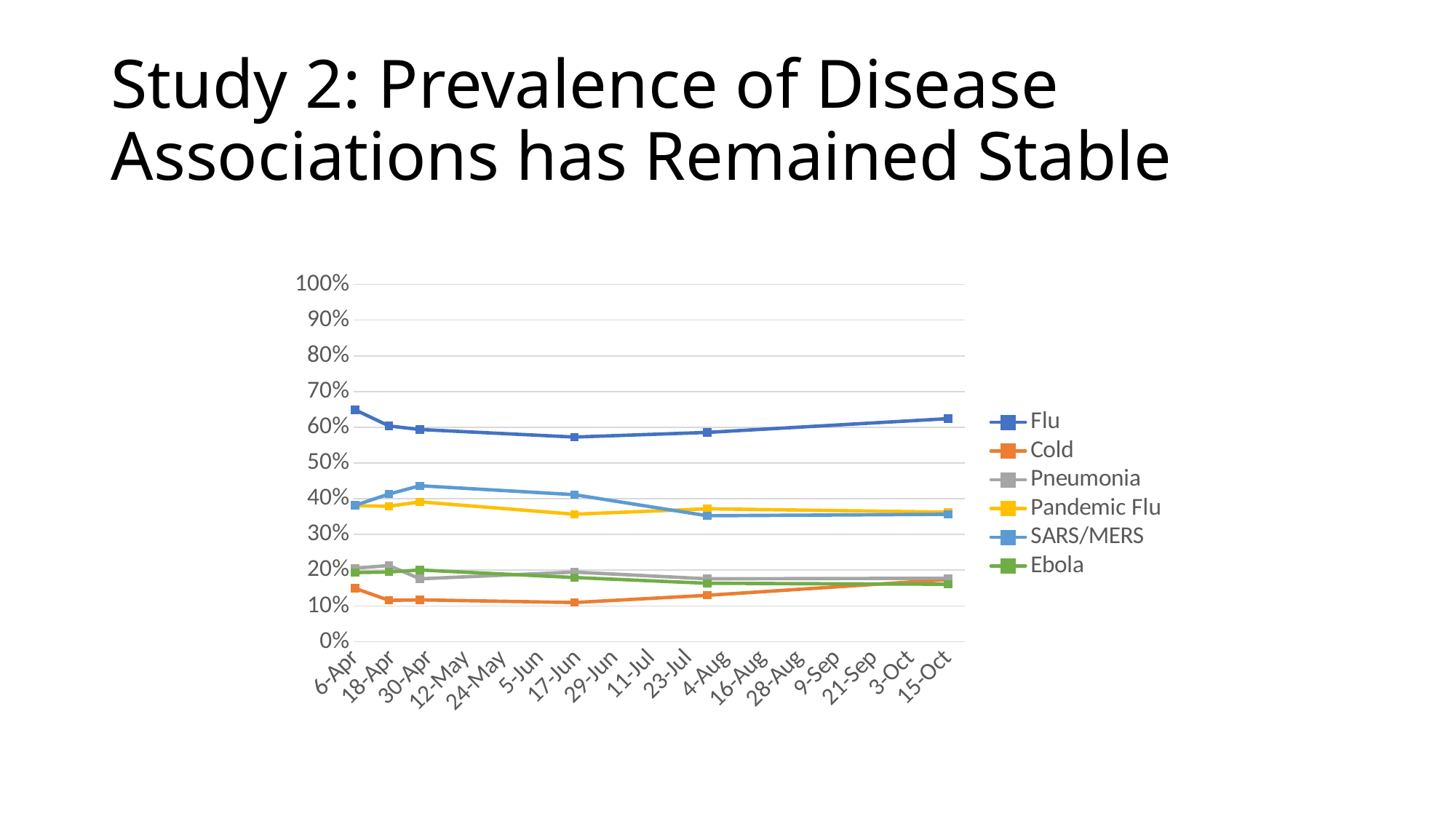
Is the value for SARS/MERS at 30-Apr greater or less than 40%? greater Is the value for Flu at 6-Apr greater or less than 60%? greater What colour is the line for Pandemic Flu in the legend? yellow How many series does the legend list? 6 Which series has the lowest value at 6-Apr? Cold Is the value for Pandemic Flu at 17-Jun greater or less than 40%? less Which series has the highest values across the whole chart? Flu What kind of chart is shown on the slide? line chart How many data points are plotted for the Flu series? 6 At 6-Apr, which is larger: the value for Flu or the value for SARS/MERS? Flu Does the Flu series rise or fall from 6-Apr to 17-Jun? fall